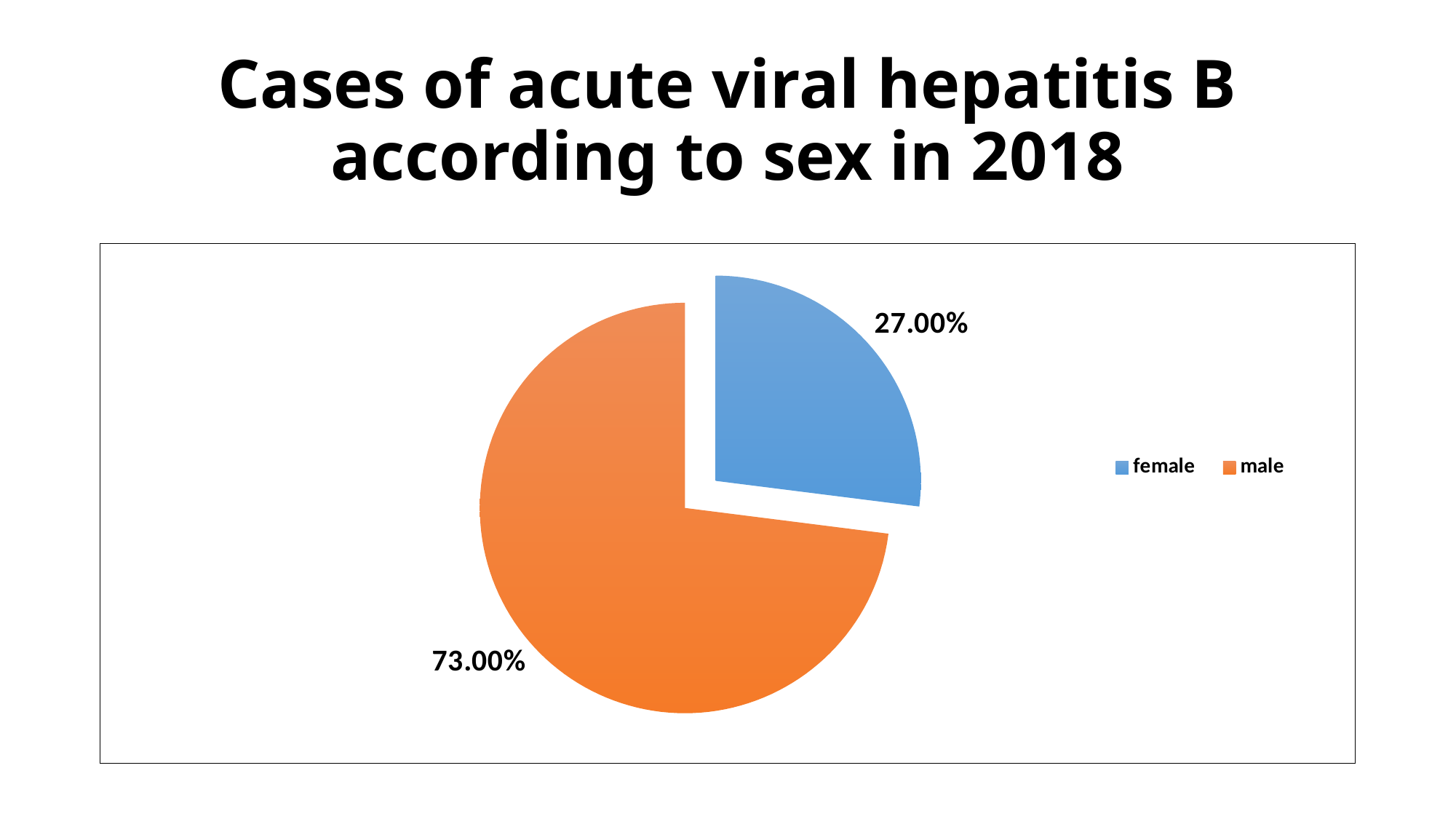
What kind of chart is shown on the slide? pie chart Which category has the largest slice of the pie? male Is the value for female greater or less than 50%? less Which slice is pulled out (exploded) from the pie? female What share of the pie does the female slice represent? 27.00% Which slice is larger, female or male? male Which category has the smallest slice of the pie? female How many slices does the pie chart have? 2 What is the difference in percentage points between the male and female slices? 46.00% What is the title of the chart? Cases of acute viral hepatitis B according to sex in 2018 What share of the pie does the male slice represent? 73.00% What colour is the male slice of the pie? orange